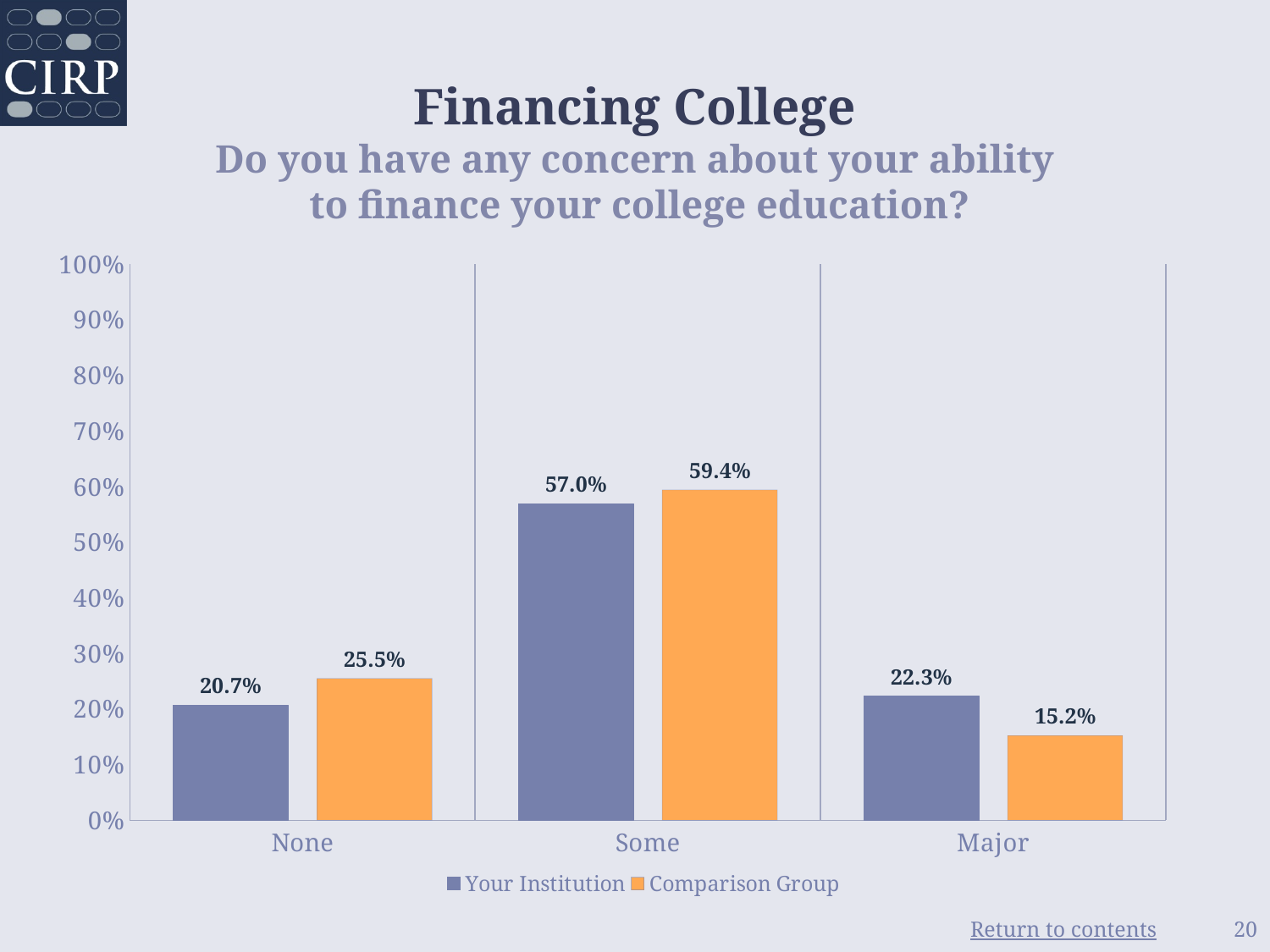
What kind of chart is shown on the slide? bar chart In the Major category, which is larger: Your Institution or Comparison Group? Your Institution How many categories are shown on the x axis? 3 What colour are the Comparison Group bars? orange What is the value for Comparison Group in the Some category? 59.4% How many series does the legend list? 2 What is the value for Your Institution in the None category? 20.7% What is the difference between Comparison Group and Your Institution in the Some category? 2.4% Which category has the lowest value for Comparison Group? Major Is the value for Comparison Group in the None category greater or less than 20%? greater What is the value for Comparison Group in the Major category? 15.2% Which category has the highest value for Your Institution? Some